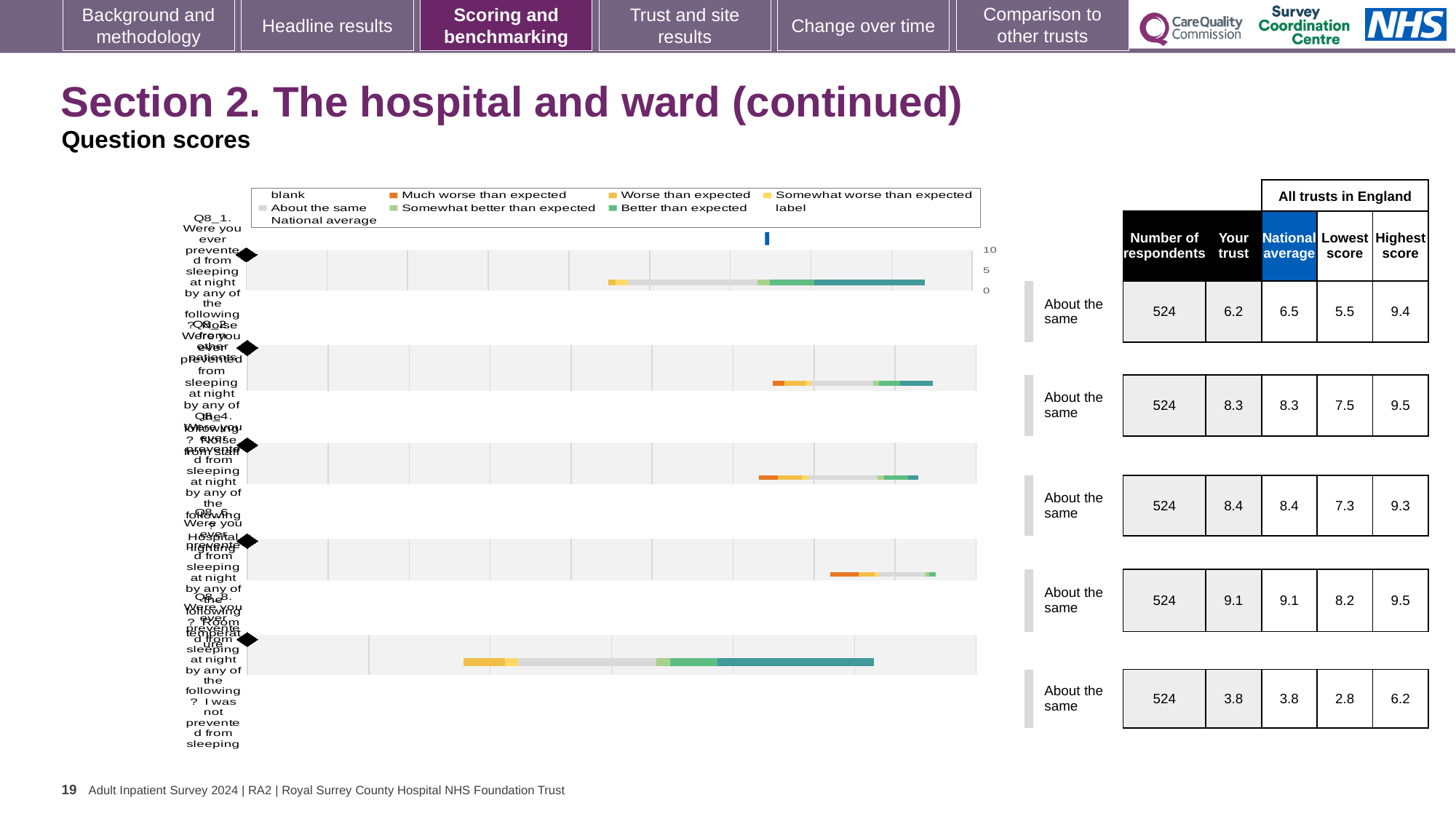
What is the 'Your trust' score for the bottom question row? 3.8 What is the national average for the first (top) question row? 6.5 For the bottom question row, what is the difference between the highest score and the lowest score across all trusts in England? 3.4 How many question rows (bars) are plotted in the chart? 5 For the top question row, which is larger: the 'Your trust' score or the national average? national average Which question row has the lowest 'Your trust' score? the bottom row (3.8) What kind of chart is used to show the question scores on this slide? bar chart What is the 'Your trust' score for the first (top) question row? 6.2 Which question row has the highest 'Your trust' score? the fourth row (9.1) What is the number of respondents shown for each question row? 524 What benchmark category is shown beside every question row? About the same In the chart legend, what colour represents 'Much worse than expected'? orange